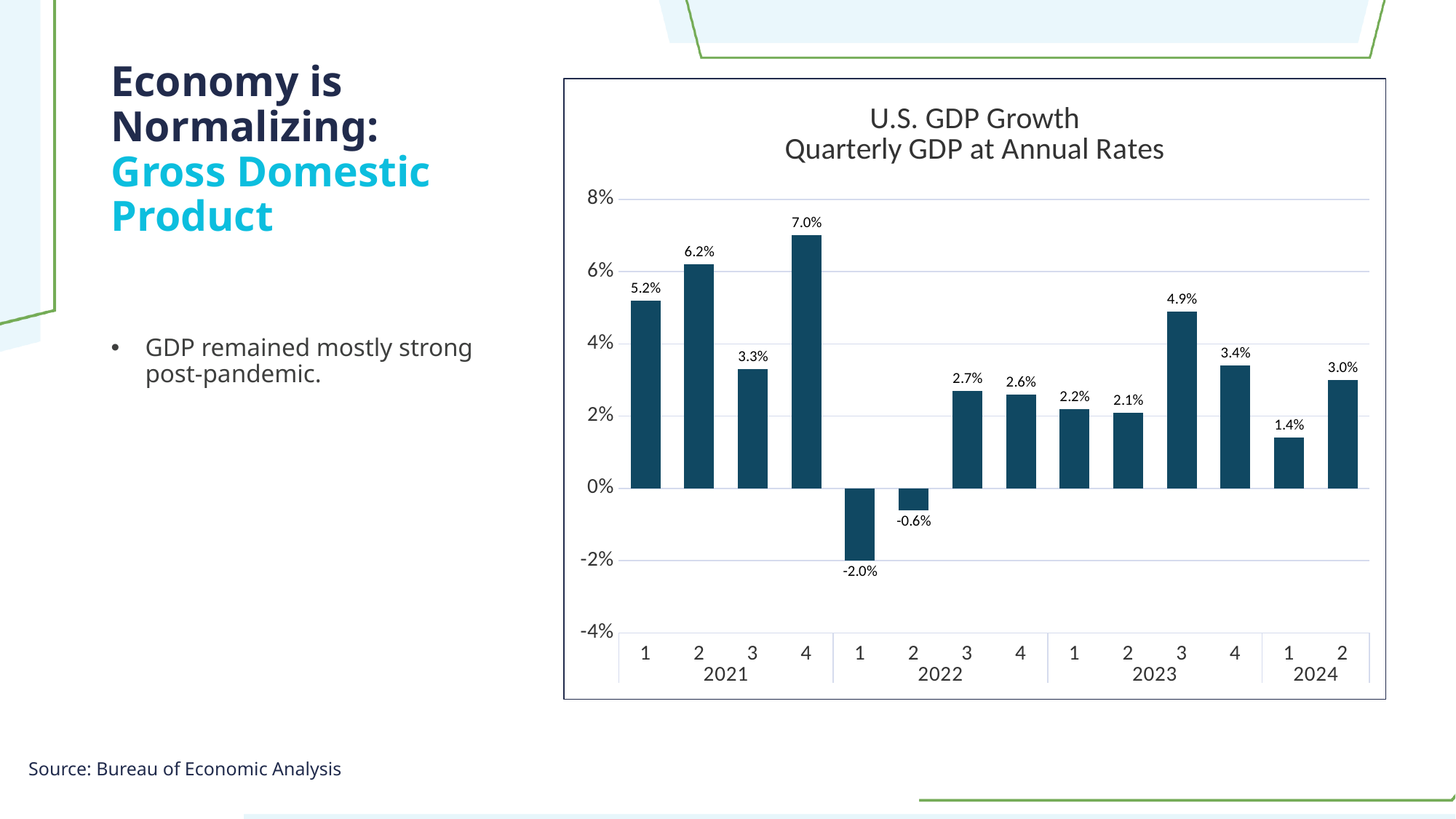
Is the GDP growth rate for Q3 2023 greater or less than 4%? greater What is the GDP growth rate for Q2 2024? 3.0% What is the GDP growth rate for Q4 2021? 7.0% What is the difference between the GDP growth rates for Q3 2023 and Q4 2023? 1.5% Which is larger, the GDP growth rate for Q2 2021 or Q1 2021? Q2 2021 How many quarters are plotted in the chart? 14 How many quarters show negative GDP growth? 2 What kind of chart is shown on the slide? Bar chart Which quarter has the lowest GDP growth rate? Q1 2022 What is the GDP growth rate for Q1 2022? -2.0% Which quarter has the highest GDP growth rate? Q4 2021 What is the title of the chart? U.S. GDP Growth Quarterly GDP at Annual Rates